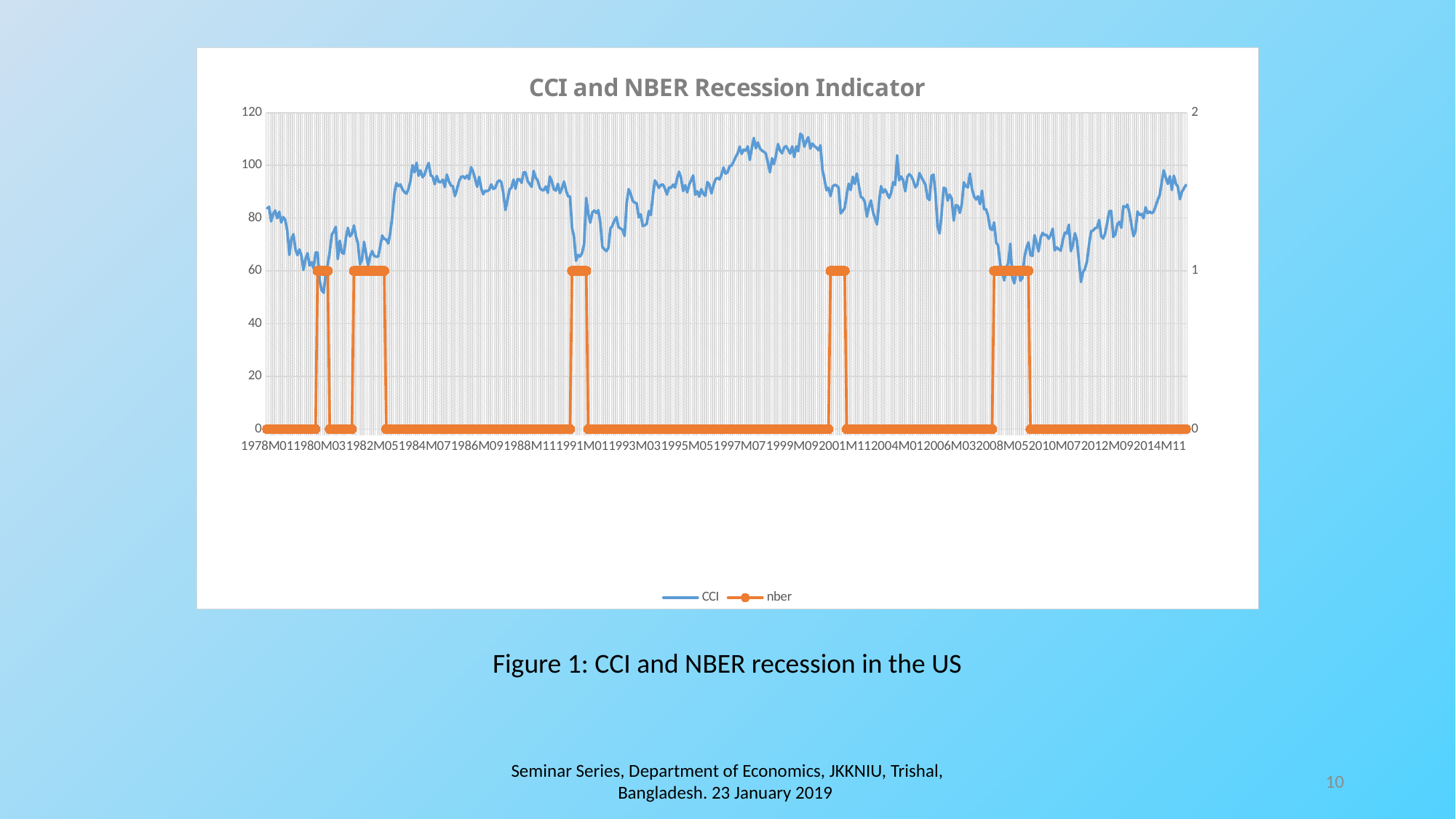
What is the value of the nber series at 1997M07? 0 Is the CCI value around 1999M09 greater or less than 100? greater What is the value of the nber series at 1984M07? 0 What is the highest value shown on the left vertical axis? 120 What kind of chart is shown on the slide? line chart How many separate periods does the nber series rise to 1? 5 Is the CCI value around 1984M07 greater or less than 80? greater How many series does the legend list? 2 What is the highest value shown on the right vertical axis? 2 What is the highest value the nber series reaches on the right axis? 1 What is the title of the chart? CCI and NBER Recession Indicator What are the two series named in the legend? CCI and nber